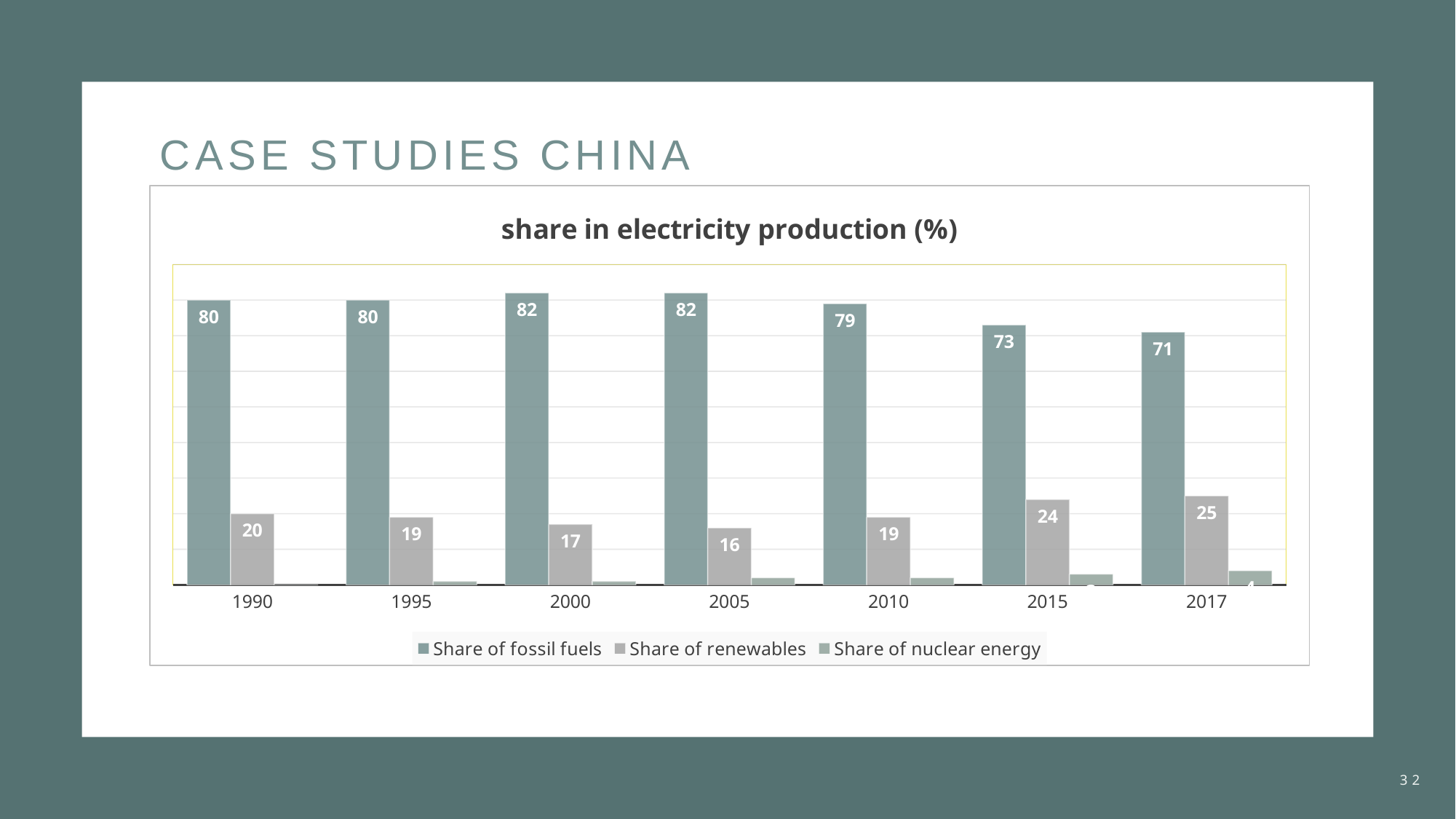
In which year is the share of renewables lowest? 2005 Which is larger: the share of renewables in 2010 or in 2015? 2015 In which year is the share of fossil fuels lowest? 2017 How many series does the legend list? 3 What is the share of renewables in 2017? 25 What is the share of renewables in 2005? 16 What is the share of fossil fuels in 2015? 73 What kind of chart is shown on the slide? Bar chart How many years are shown on the x axis? 7 In which year is the share of renewables highest? 2017 What is the difference between the share of fossil fuels and the share of renewables in 1990? 60 What is the share of fossil fuels in 2000? 82